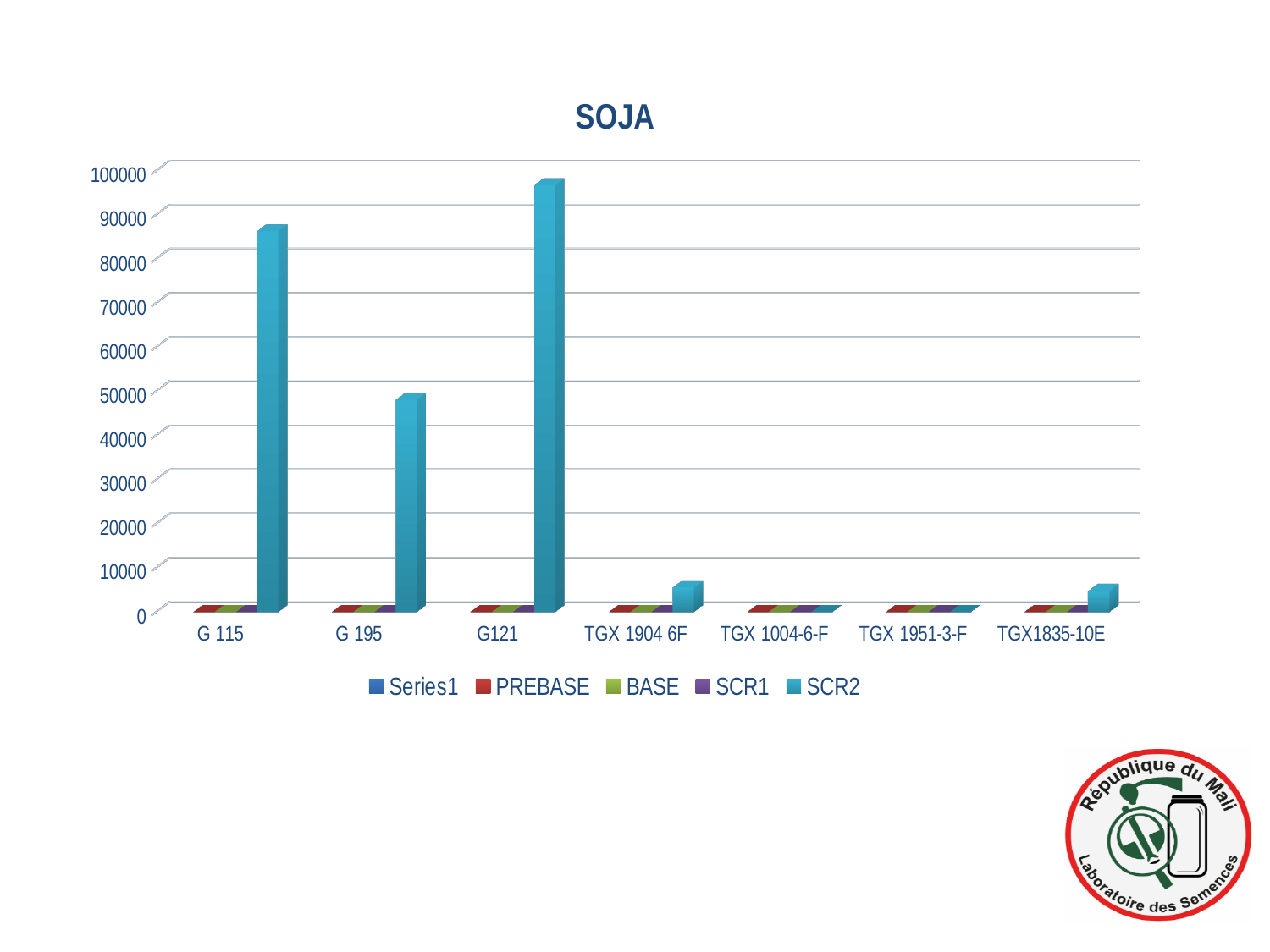
Which is larger, the SCR2 value for G 115 or for G 195? G 115 Is the SCR2 value for G 115 greater or less than 80000? greater What kind of chart is shown on the slide? bar chart How many series does the legend list? 5 What is the title of the chart? SOJA Which series is shown in the legend immediately after PREBASE? BASE Is the SCR2 value for G121 greater or less than 90000? greater Which category has the highest SCR2 value? G121 Which is larger, the SCR2 value for G121 or for TGX 1904 6F? G121 How many categories are shown on the x axis of the chart? 7 Is the SCR2 value for TGX 1904 6F greater or less than 10000? less